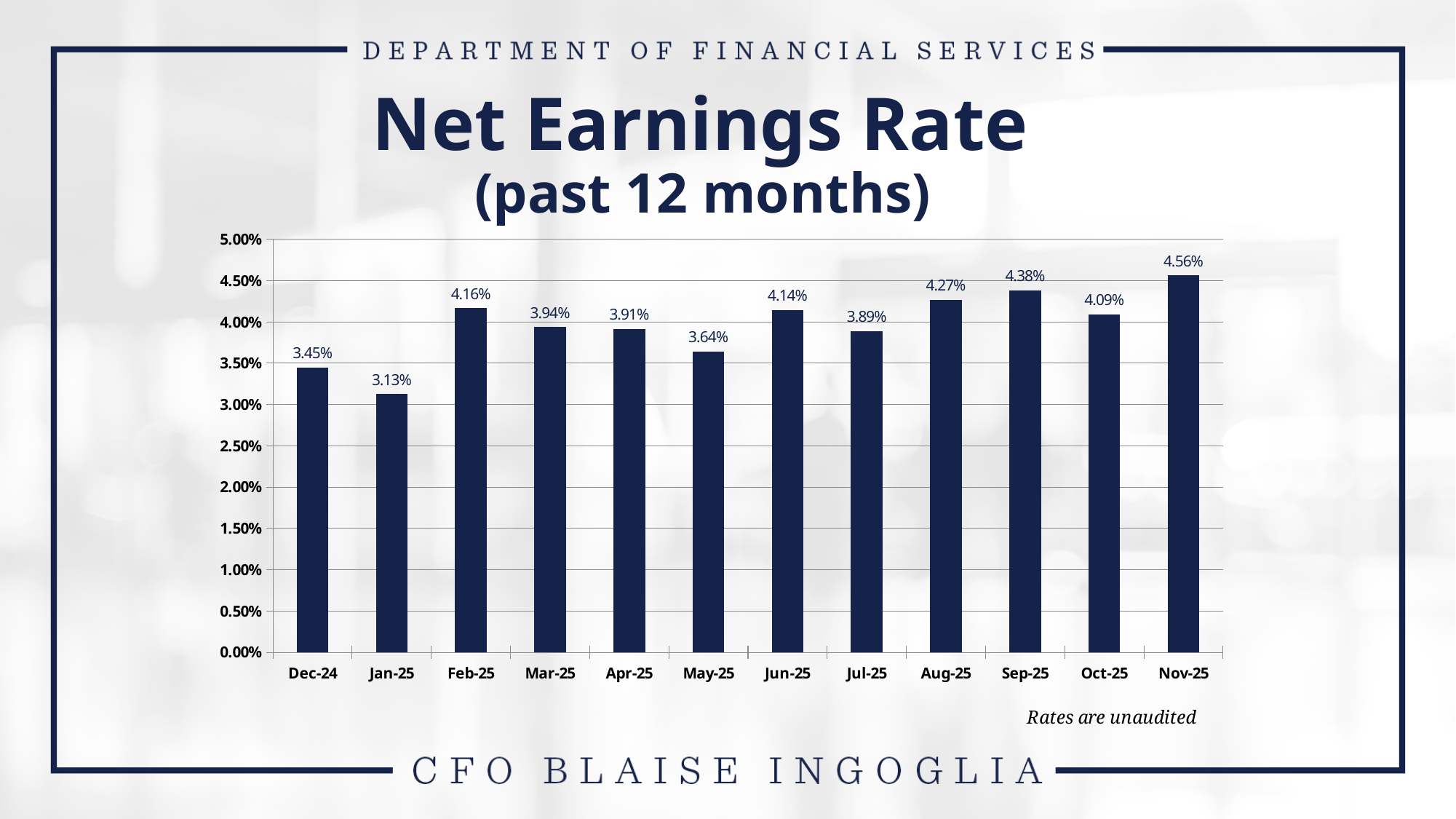
Is the net earnings rate for Jul-25 greater or less than 4.00%? less What kind of chart is shown on the slide? Bar chart What is the net earnings rate for Oct-25? 4.09% Which month has the highest net earnings rate? Nov-25 Does the net earnings rate rise or fall from Jul-25 to Sep-25? Rise How many months are shown on the chart? 12 What note appears below the chart about the rates? Rates are unaudited What is the net earnings rate for Feb-25? 4.16% What is the difference between the net earnings rate in Nov-25 and Dec-24? 1.11% What is the net earnings rate for May-25? 3.64% Which month has a higher net earnings rate, Sep-25 or Aug-25? Sep-25 Which month has the lowest net earnings rate? Jan-25